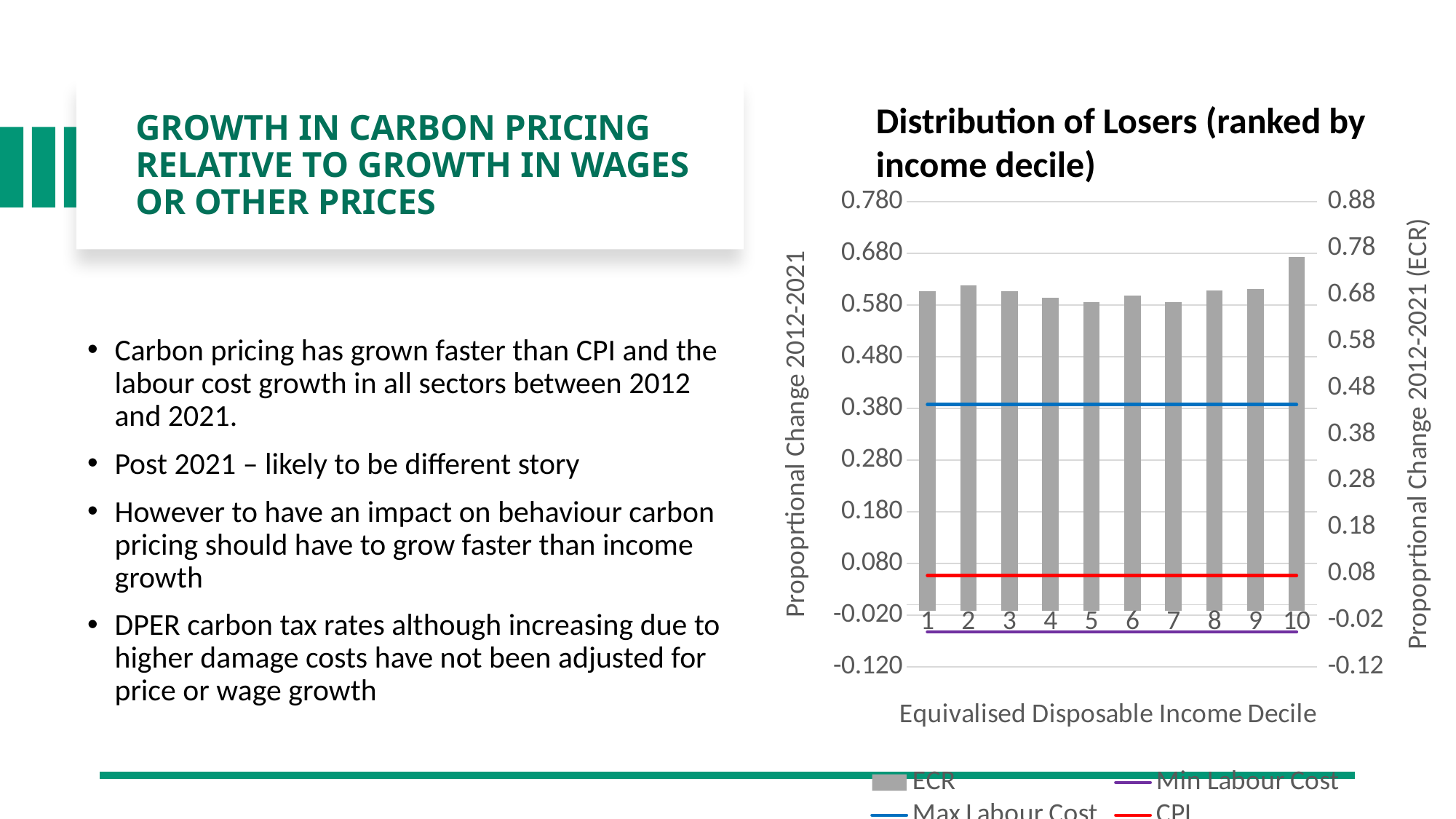
Which series in the chart is drawn as bars? ECR On the left axis, is the CPI line greater or less than 0.180? less How many income deciles are shown on the x axis of the chart? 10 How many series does the chart's legend list? 4 Which income decile has the highest ECR bar? 10 Is the ECR bar for decile 10 larger or smaller than the ECR bar for decile 1? larger What is the x-axis label of the chart? Equivalised Disposable Income Decile What is the title of the chart on the slide? Distribution of Losers (ranked by income decile) On the left axis, is the Max Labour Cost line greater or less than 0.280? greater Is the Max Labour Cost line above or below the CPI line in the chart? above On the left axis, is the Max Labour Cost line greater or less than 0.480? less